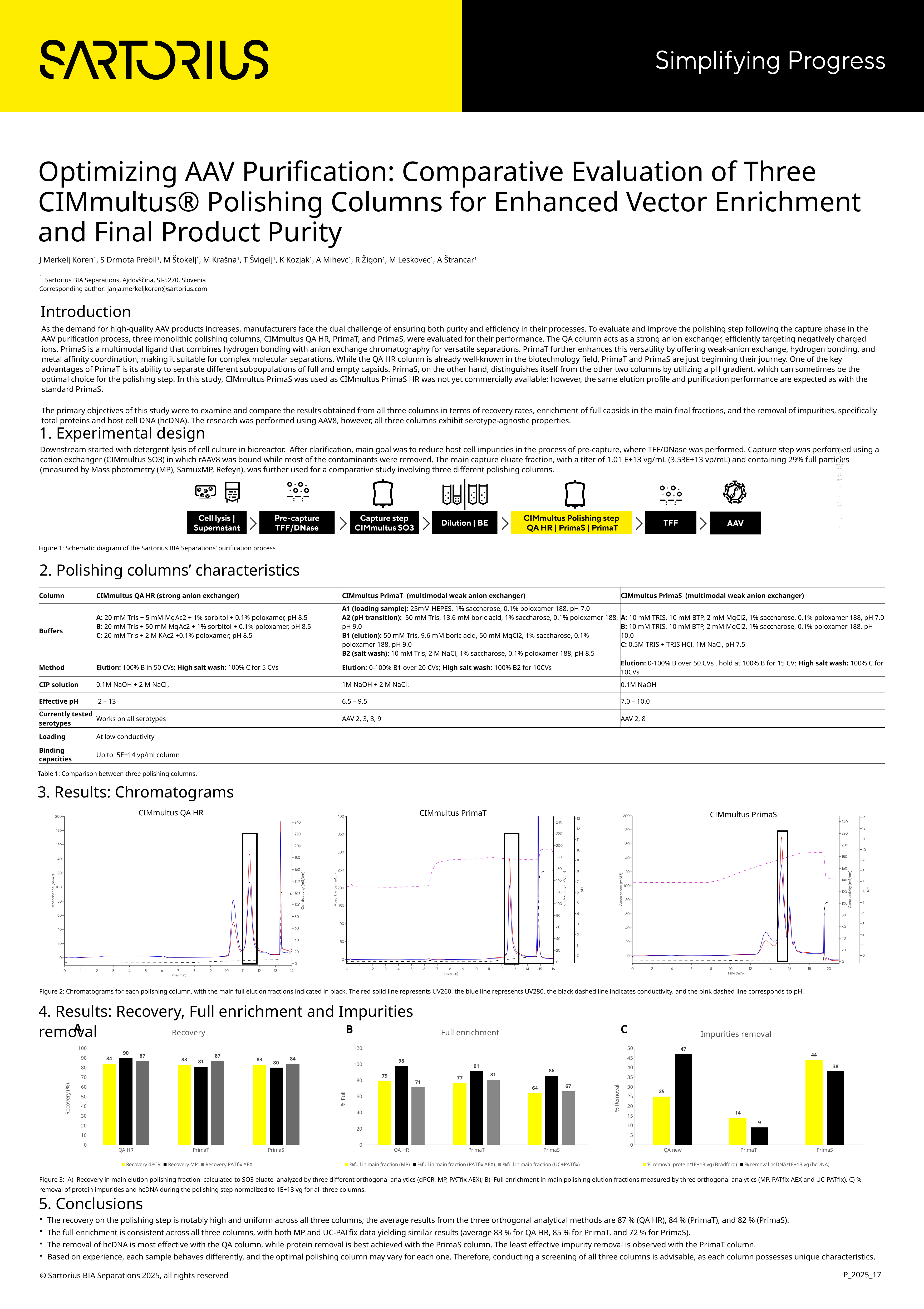
In the Impurities removal chart, which column has the lowest % removal hcDNA value? PrimaT In the Recovery chart, what is the Recovery MP value for QA HR? 90 In the Full enrichment chart, what is the %full in main fraction (PATfix AEX) value for PrimaT? 91 In the Impurities removal chart, what is the % removal hcDNA value for QA new? 47 In the Recovery chart, how many series does the legend list? 3 In the Full enrichment chart, which column has the highest %full in main fraction (PATfix AEX) value? QA HR In the Full enrichment chart, which is larger: the %full in main fraction (UC+PATfix) value for PrimaT or for PrimaS? PrimaT In the Impurities removal chart, how many columns are shown on the x axis? 3 In the Full enrichment chart, what is the difference between the %full in main fraction (MP) values for QA HR and PrimaS? 15 In the Impurities removal chart, what is the difference between the % removal protein values for PrimaS and PrimaT? 30 In the Recovery chart, what is the Recovery dPCR value for PrimaS? 83 What type of chart is the Recovery chart? Bar chart